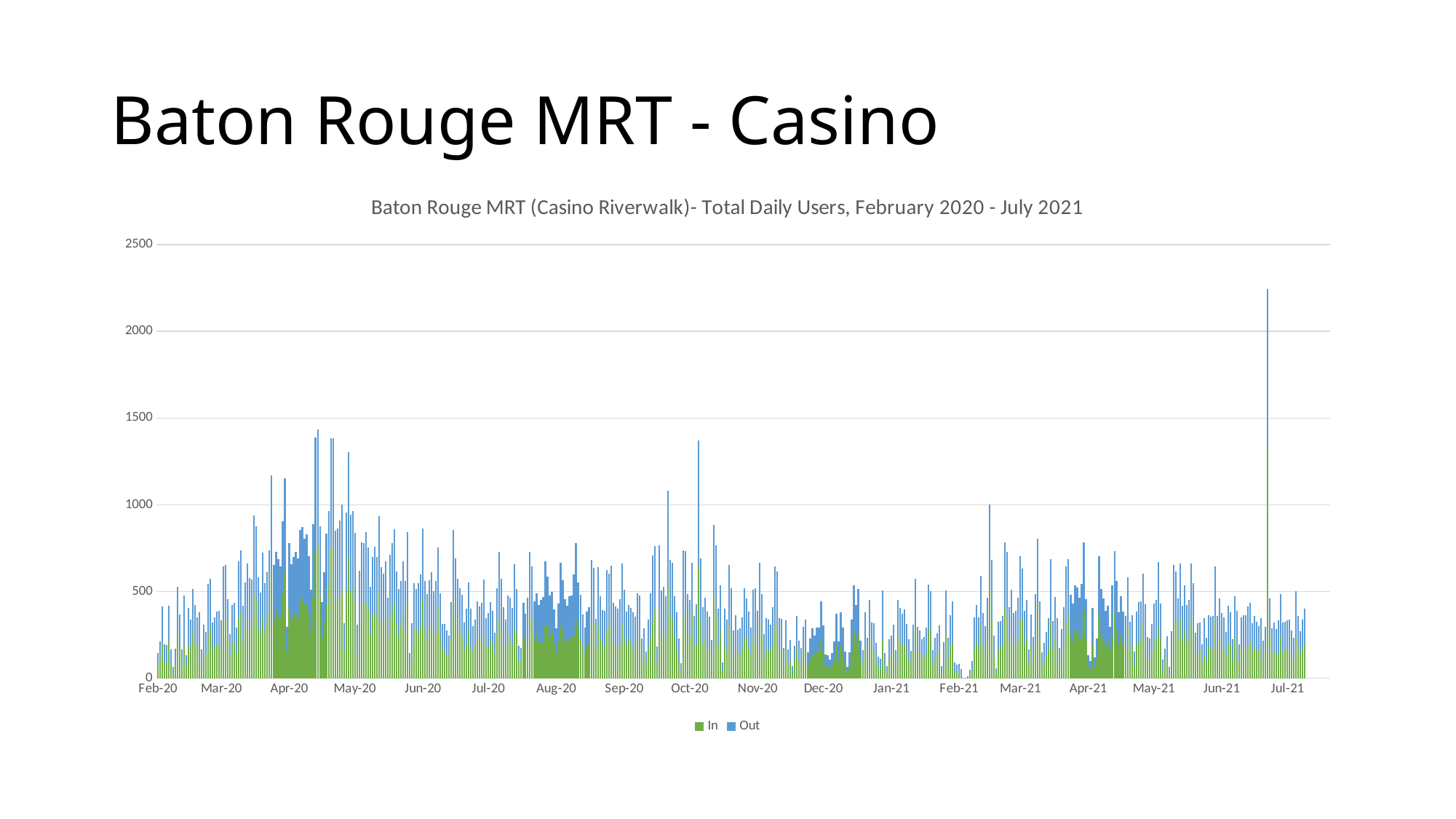
What kind of chart is shown on the slide? Bar chart Is the tallest bar on the chart greater or less than 2500? less What is the title of the chart? Baton Rouge MRT (Casino Riverwalk)- Total Daily Users, February 2020 - July 2021 Is the tallest bar in April 2020 greater or less than 1000? greater Which month label is last on the x axis? Jul-21 How many month labels are shown along the x axis? 18 Is the tallest bar on the chart, near the end of June 2021, greater or less than 2000? greater How many series does the legend list? 2 What are the two series named in the legend? In and Out What is the highest value shown on the y axis? 2500 Which month label is first on the x axis? Feb-20